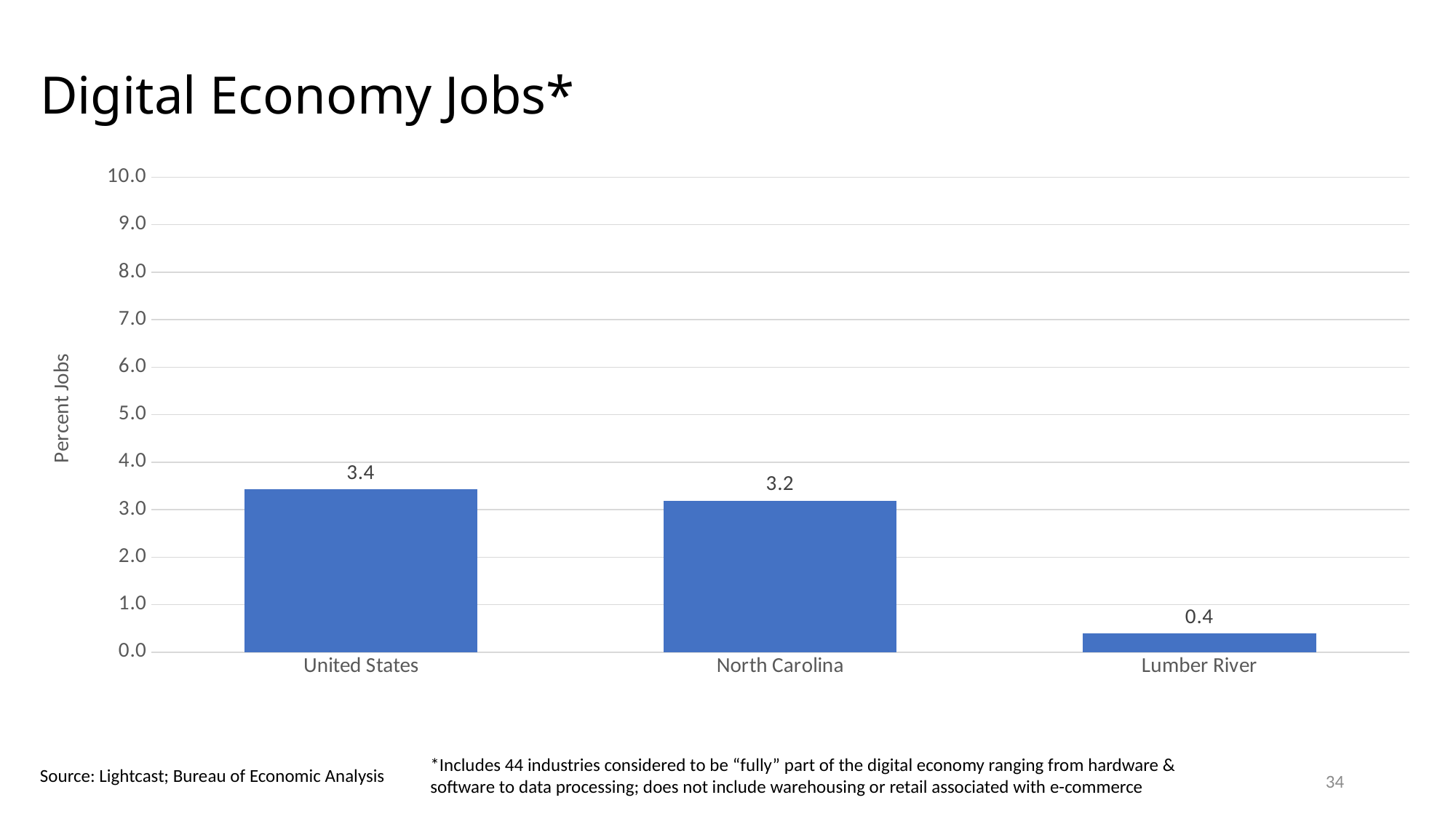
Which category has the lowest value? Lumber River What is the value for North Carolina? 3.2 What is the value for Lumber River? 0.4 Which category has the highest value? United States Which is larger, the value for North Carolina or the value for Lumber River? North Carolina What is the difference between the values for United States and Lumber River? 3.0 Is the value for Lumber River greater or less than 1.0? less What is the value for United States? 3.4 What is the label of the vertical axis? Percent Jobs How many categories are shown on the x axis? 3 What kind of chart is shown on the slide? bar chart What is the difference between the values for North Carolina and Lumber River? 2.8